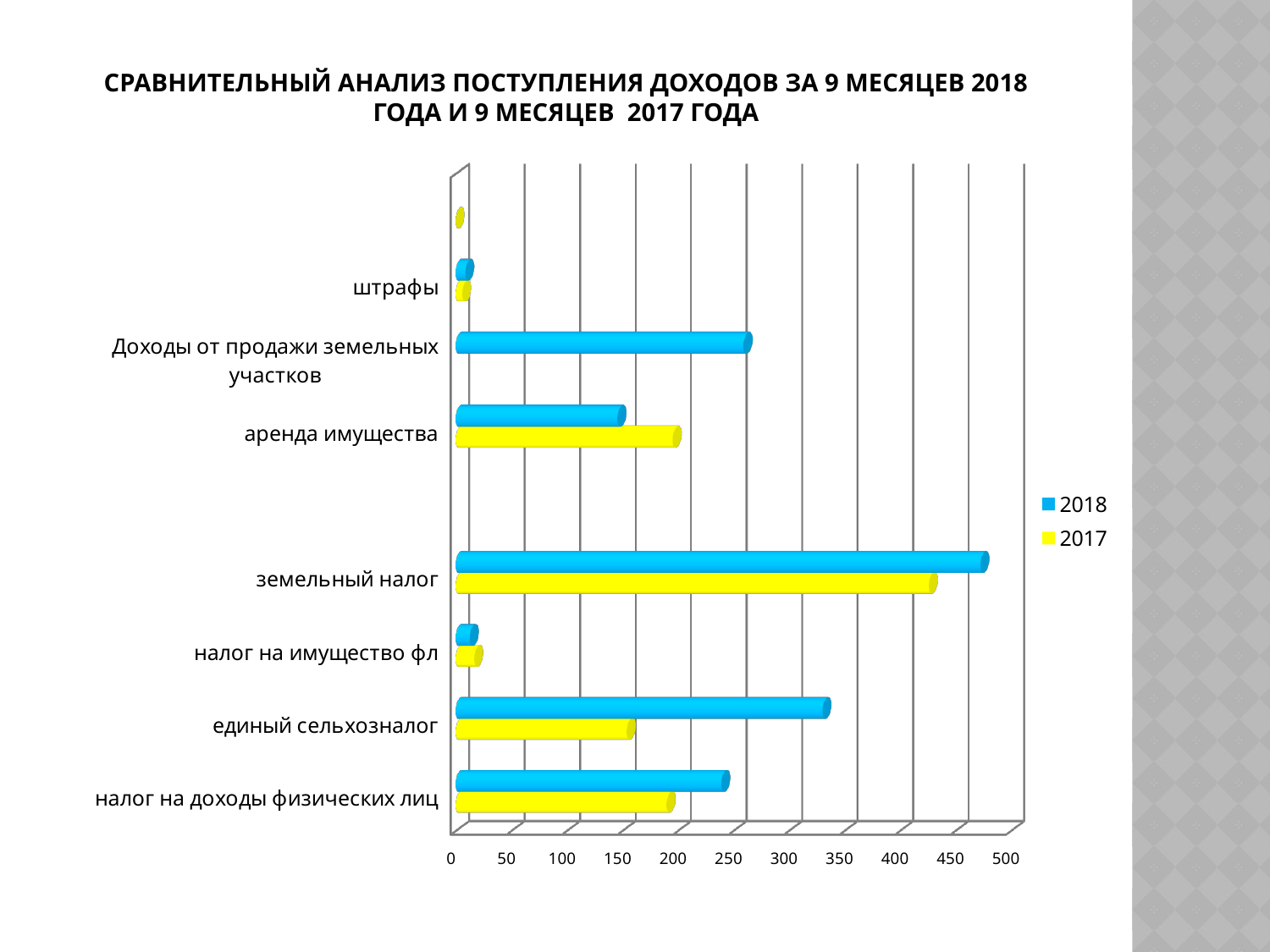
Which category has the highest value for 2017? земельный налог Is the 2018 value for единый сельхозналог greater or less than 300? greater Which series does the legend show in blue? 2018 Is the 2017 value for единый сельхозналог greater or less than 200? less What kind of chart is shown on the slide? bar chart Which category has the highest value for 2018? земельный налог Is the 2018 value for налог на доходы физических лиц greater or less than 200? greater How many series does the legend list? 2 For аренда имущества, which year has the larger value, 2018 or 2017? 2017 For единый сельхозналог, which year has the larger value, 2018 or 2017? 2018